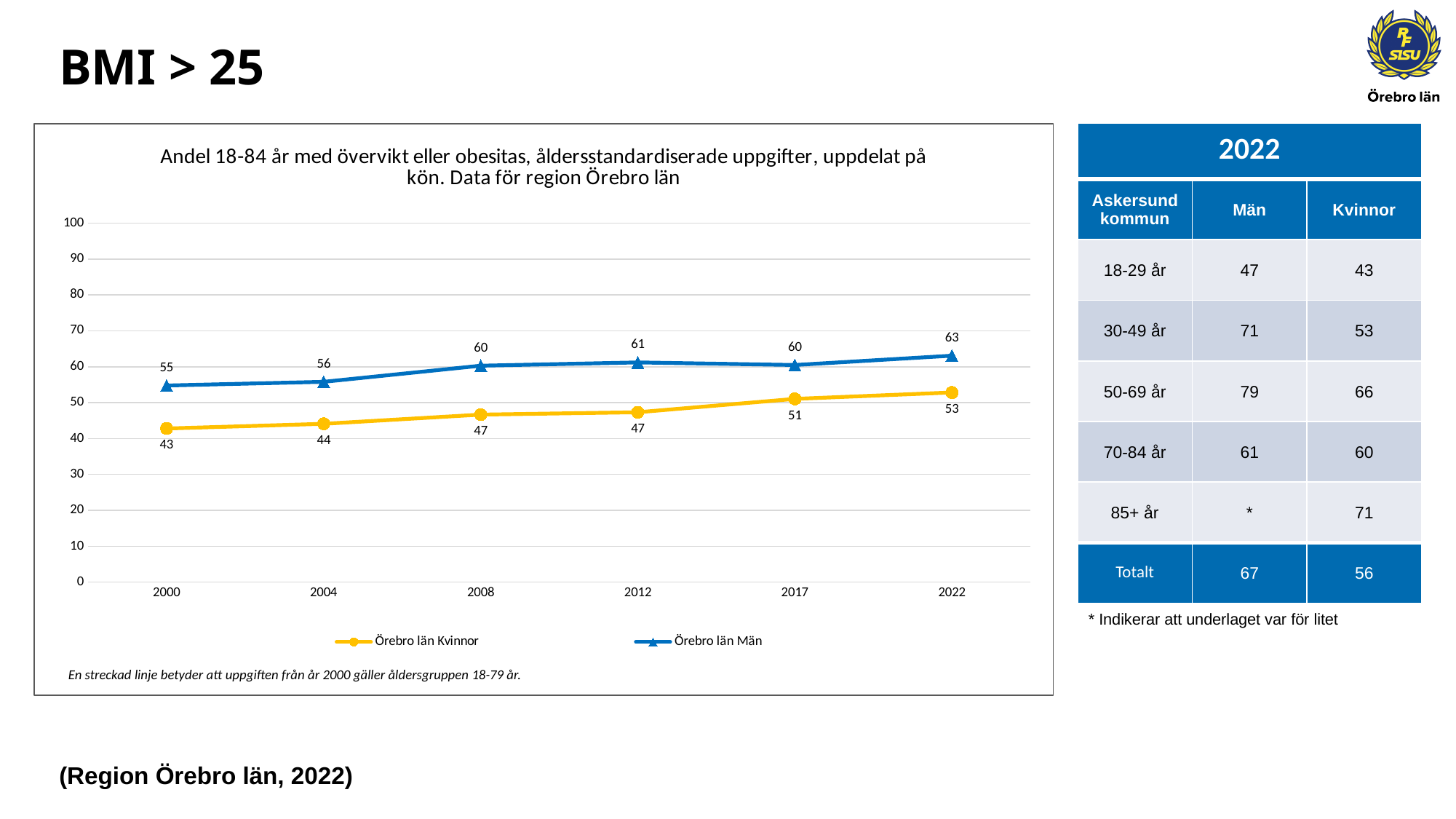
How many years are plotted on the x axis? 6 Which series has the larger value in 2008, Örebro län Kvinnor or Örebro län Män? Örebro län Män What is the difference between Örebro län Män and Örebro län Kvinnor in 2022? 10 What is the value for Örebro län Män in 2022? 63 How many series does the legend list? 2 What is the value for Örebro län Män in 2012? 61 What type of chart is shown on the slide? line chart What is the value for Örebro län Kvinnor in 2000? 43 In which year is the value for Örebro län Män highest? 2022 What is the value for Örebro län Kvinnor in 2017? 51 Does the value for Örebro län Kvinnor rise or fall from 2000 to 2022? rise In which year is the value for Örebro län Kvinnor lowest? 2000